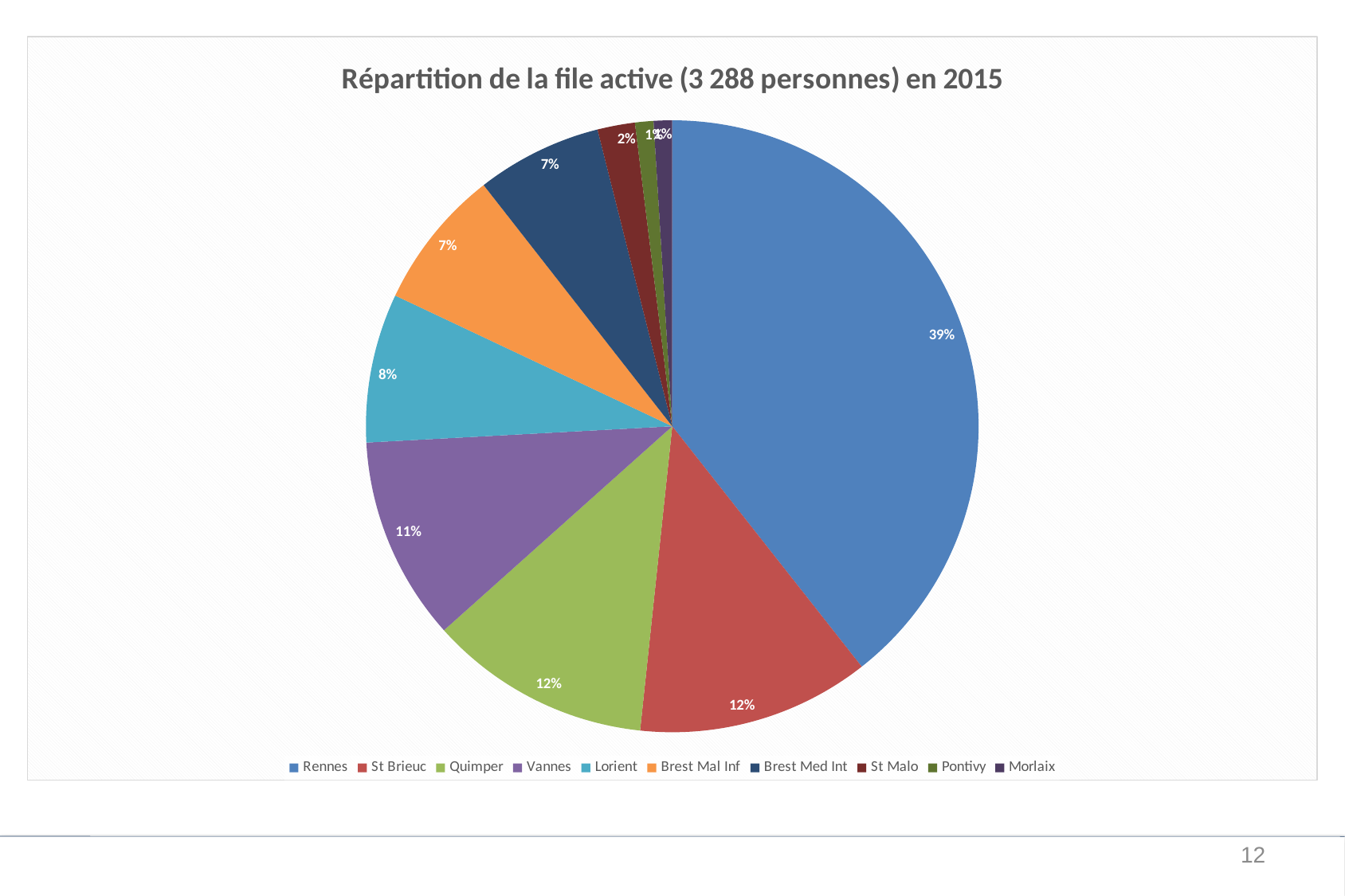
Which is larger, the slice for Vannes or the slice for Lorient? Vannes How many categories does the legend list? 10 What is the difference in percentage points between Rennes and St Brieuc? 27 percentage points What is the value shown for Lorient? 8% What is the value shown for Vannes? 11% What is the value shown for Quimper? 12% Which category has the largest slice of the pie? Rennes What share of the pie does Rennes represent? 39% What is the title of the chart? Répartition de la file active (3 288 personnes) en 2015 What is the value shown for Brest Mal Inf? 7% What is the value shown for St Malo? 2% What kind of chart is shown on the slide? Pie chart